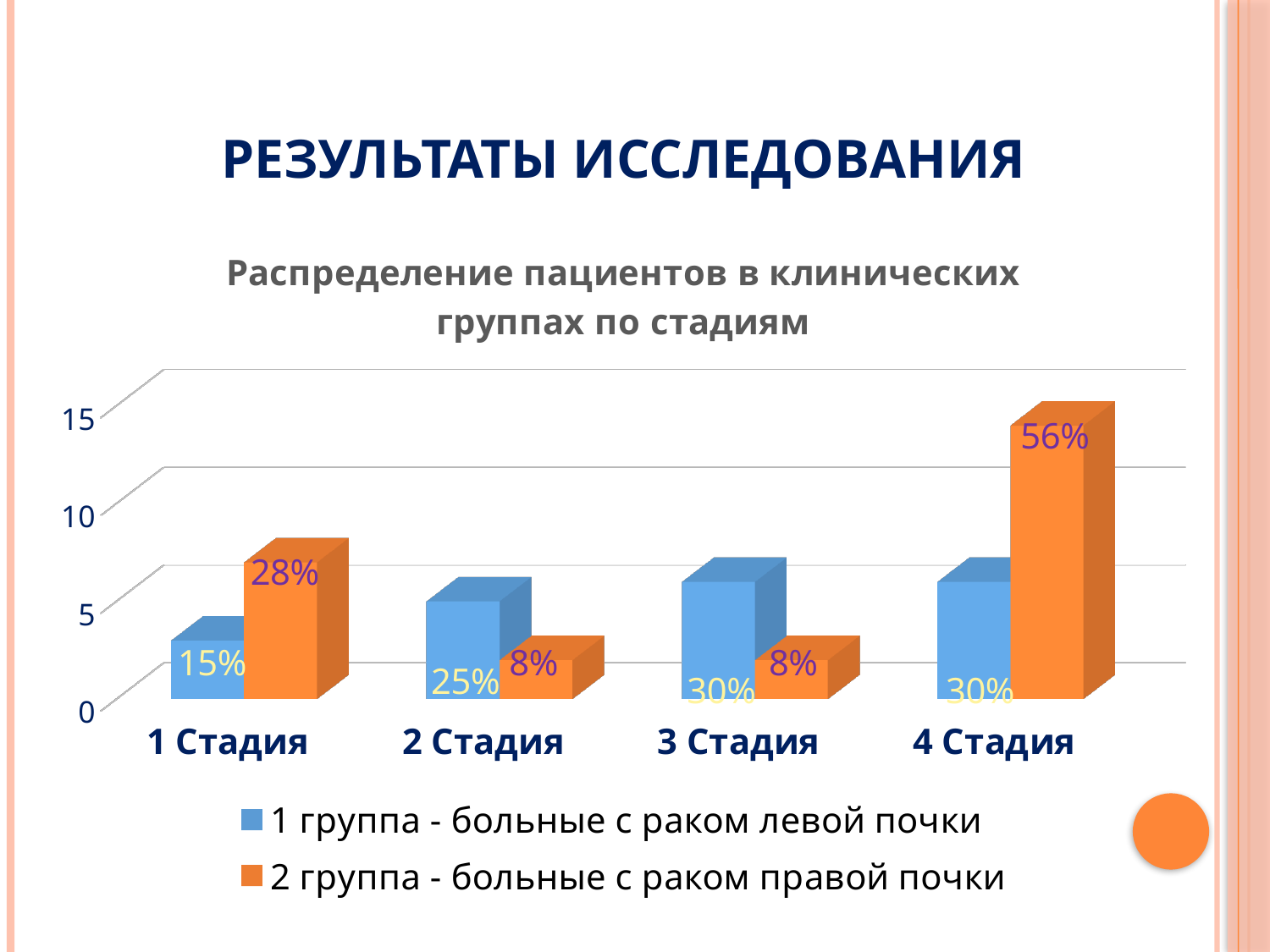
What is the data label on the bar for '2 группа - больные с раком правой почки' at 4 Стадия? 56% At which stage does '1 группа - больные с раком левой почки' have its lowest bar? 1 Стадия How many stage categories are shown on the x axis? 4 What is the data label on the bar for '2 группа - больные с раком правой почки' at 1 Стадия? 28% How many series does the legend list? 2 At 3 Стадия, which series has the larger bar: '1 группа' or '2 группа'? 1 группа - больные с раком левой почки What is the data label on the bar for '1 группа - больные с раком левой почки' at 1 Стадия? 15% What is the difference between the labelled percentages for '2 группа' at 4 Стадия and at 1 Стадия? 28% At which stage does '2 группа - больные с раком правой почки' have its highest bar? 4 Стадия What type of chart is shown on the slide? Bar chart What is the data label on the bar for '1 группа - больные с раком левой почки' at 2 Стадия? 25% Is the bar for '2 группа - больные с раком правой почки' at 4 Стадия greater or less than 10 on the vertical axis? greater